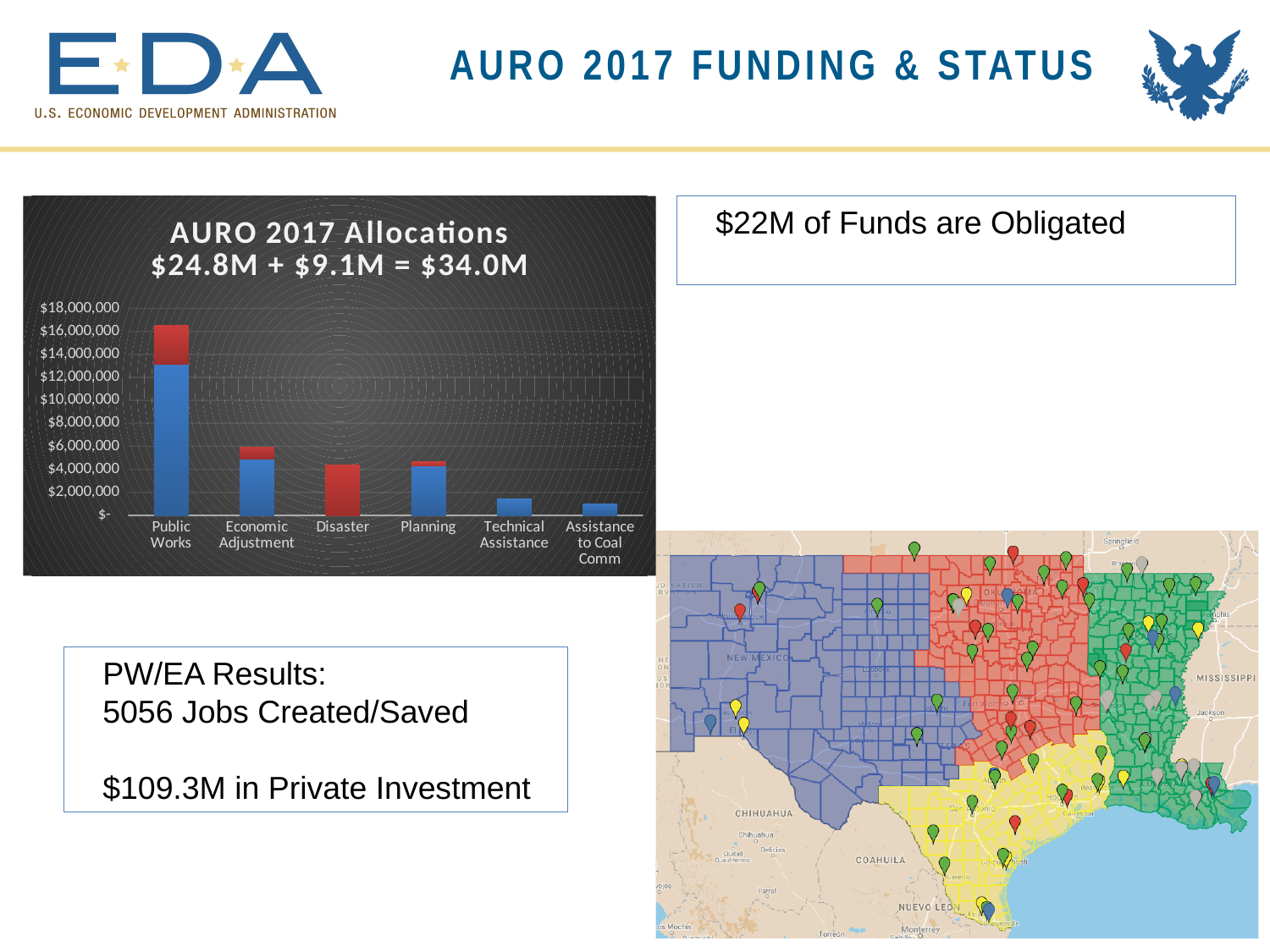
How many categories are shown on the x axis of the AURO 2017 Allocations chart? 6 Is the value for Disaster greater or less than $6,000,000? less Which has a larger total allocation, Public Works or Economic Adjustment? Public Works Is the total value for Economic Adjustment greater or less than $8,000,000? less Is the value for Technical Assistance greater or less than $2,000,000? less What is the title of the bar chart on the slide? AURO 2017 Allocations $24.8M + $9.1M = $34.0M Which category has the lowest total allocation in the AURO 2017 Allocations chart? Assistance to Coal Comm Which category in the AURO 2017 Allocations chart is shown entirely in red with no blue segment? Disaster Which has a larger total allocation, Economic Adjustment or Disaster? Economic Adjustment What kind of chart is the AURO 2017 Allocations chart? Bar chart Which category has the highest total allocation in the AURO 2017 Allocations chart? Public Works